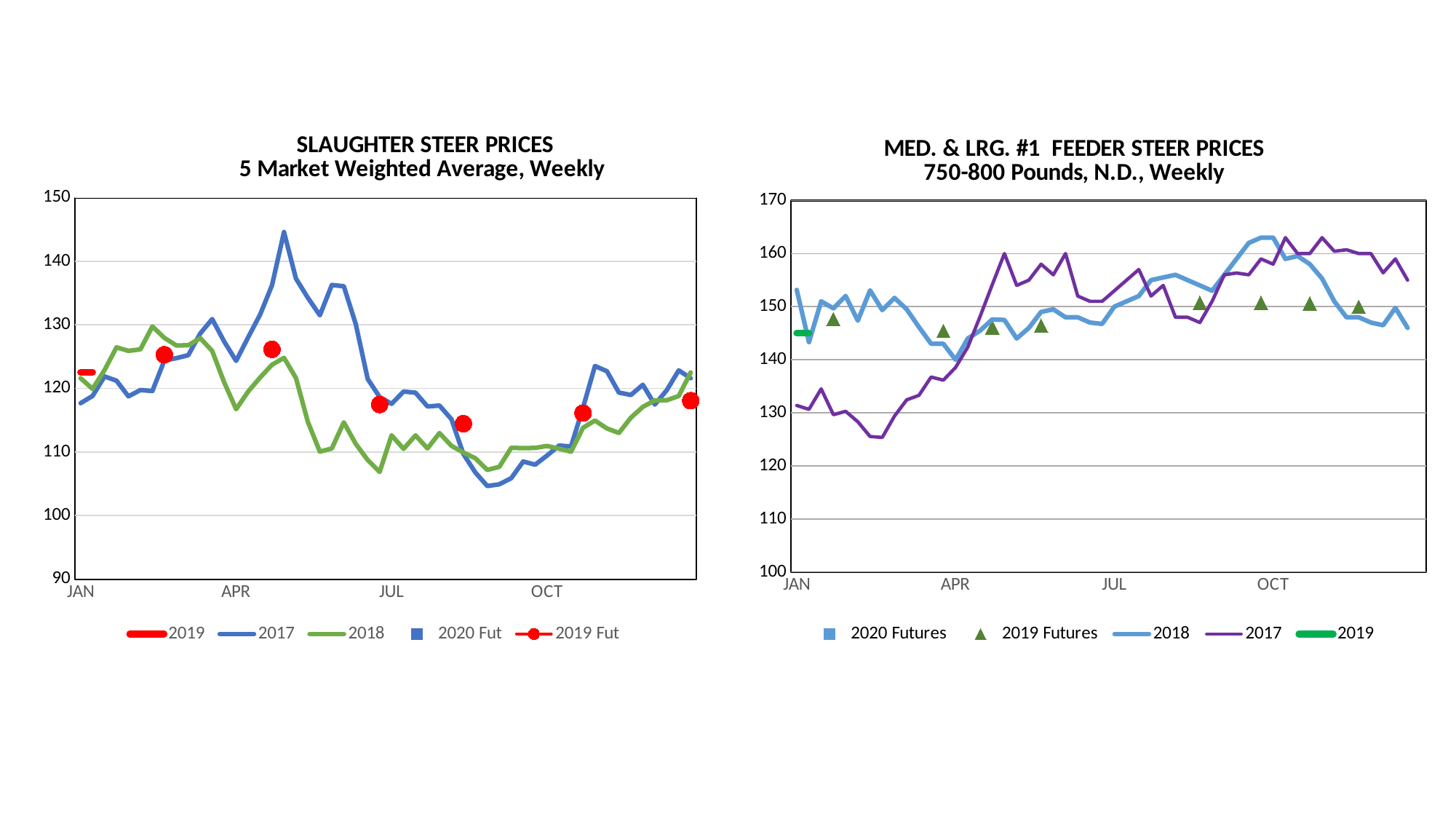
What kind of chart is the MED. & LRG. #1 FEEDER STEER PRICES chart on the right? line chart What kind of chart is the SLAUGHTER STEER PRICES chart on the left? line chart In the MED. & LRG. #1 FEEDER STEER PRICES chart, is the peak of the 2018 line around October greater or less than 160? greater In the SLAUGHTER STEER PRICES chart, does the 2018 line rise or fall from April to July? fall In the MED. & LRG. #1 FEEDER STEER PRICES chart, which line is higher in January, 2018 or 2017? 2018 How many series does the legend of the SLAUGHTER STEER PRICES chart list? 5 How many series does the legend of the MED. & LRG. #1 FEEDER STEER PRICES chart list? 5 In the SLAUGHTER STEER PRICES chart, is the lowest value of the 2018 line around July greater or less than 110? less In the SLAUGHTER STEER PRICES chart, is the peak value of the 2017 line in April greater or less than 140? greater In the SLAUGHTER STEER PRICES chart, which series reaches the highest value on the chart? 2017 In the MED. & LRG. #1 FEEDER STEER PRICES chart, does the 2017 line rise or fall from January to April? rise